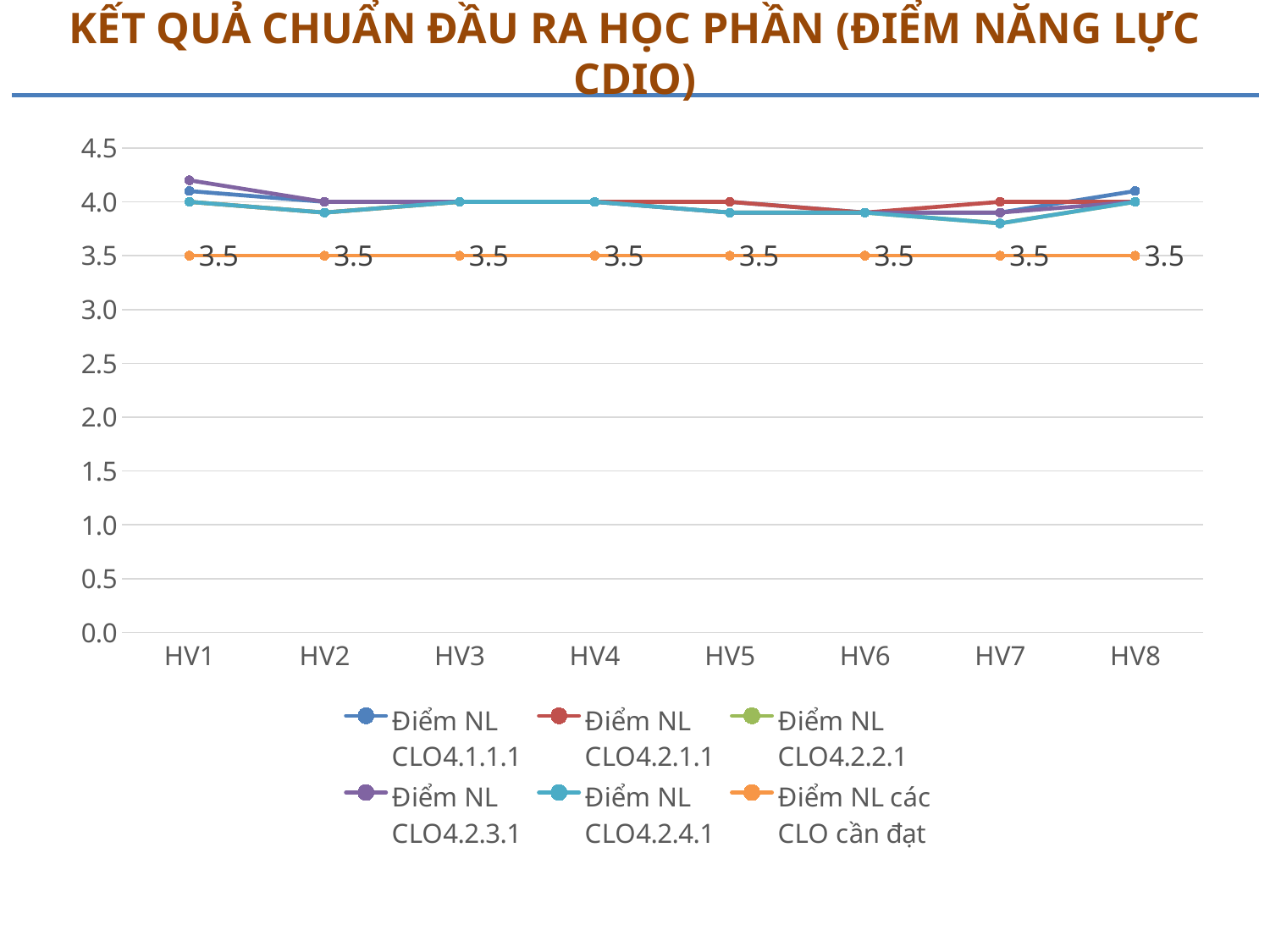
Is the value for "Điểm NL CLO4.2.3.1" at HV1 greater or less than 4.0? greater At HV1, which is larger: "Điểm NL CLO4.2.3.1" or "Điểm NL các CLO cần đạt"? Điểm NL CLO4.2.3.1 What colour is the line for "Điểm NL các CLO cần đạt"? orange What kind of chart is shown on the slide? line chart Is the value for "Điểm NL các CLO cần đạt" at HV5 greater or less than 4.0? less How many series does the legend list? 6 What is the value of "Điểm NL các CLO cần đạt" at HV1? 3.5 What is the title of the slide? KẾT QUẢ CHUẨN ĐẦU RA HỌC PHẦN (ĐIỂM NĂNG LỰC CDIO) Is the value for "Điểm NL CLO4.2.4.1" at HV7 greater or less than 4.0? less How many categories (HV1 to HV8) are plotted on the x axis? 8 What is the value of "Điểm NL các CLO cần đạt" at HV8? 3.5 Does the "Điểm NL các CLO cần đạt" series rise, fall, or stay flat from HV1 to HV8? stays flat